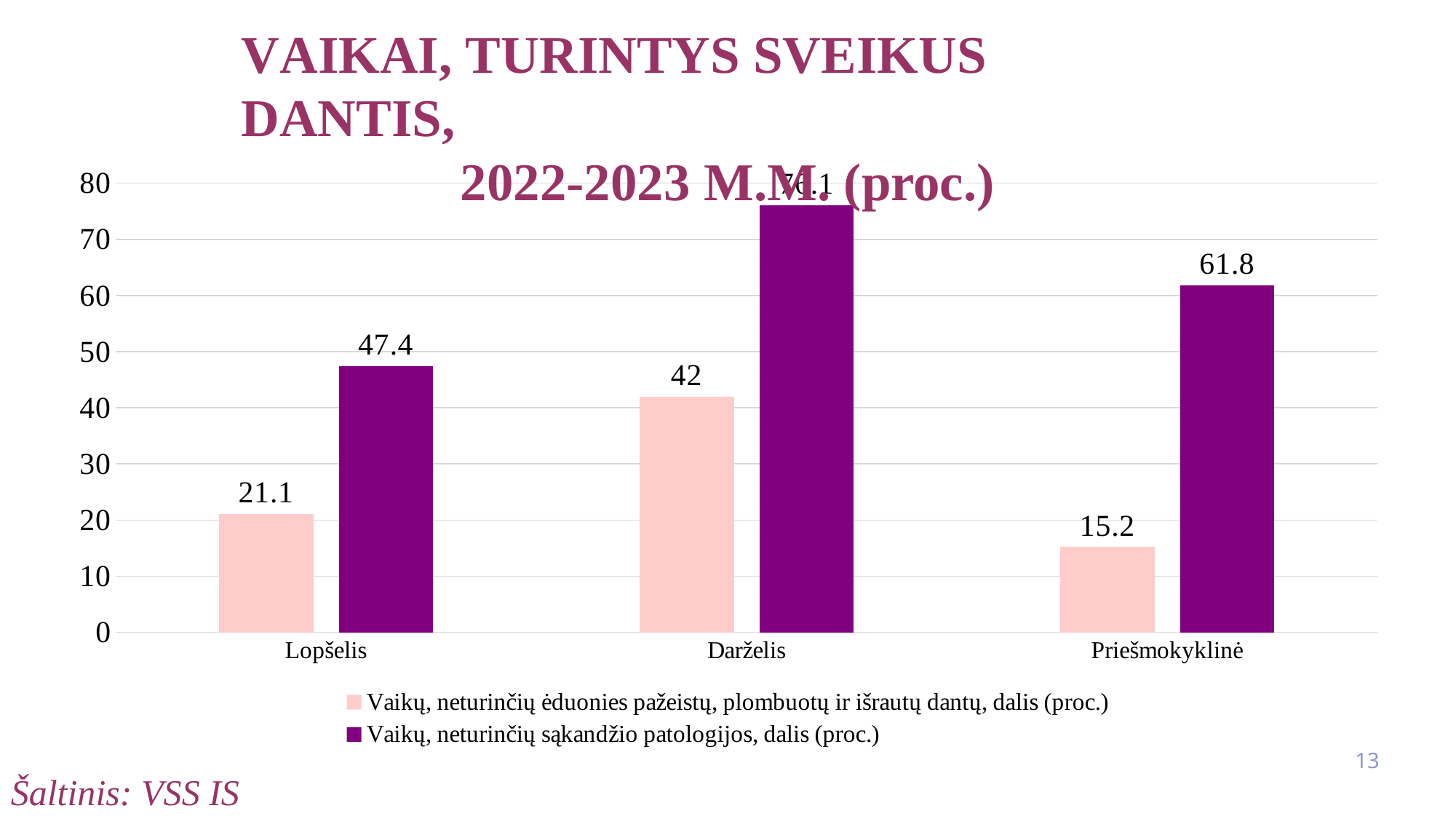
What kind of chart is shown on the slide? bar chart What is the value for Lopšelis in the series 'Vaikų, neturinčių sąkandžio patologijos, dalis (proc.)'? 47.4 Is the value for Darželis in the series 'Vaikų, neturinčių sąkandžio patologijos, dalis (proc.)' greater or less than 70? greater What is the value for Lopšelis in the series 'Vaikų, neturinčių ėduonies pažeistų, plombuotų ir išrautų dantų, dalis (proc.)'? 21.1 Which category has the highest value in the series 'Vaikų, neturinčių sąkandžio patologijos, dalis (proc.)'? Darželis Which is larger: the value for Lopšelis or for Darželis in the series 'Vaikų, neturinčių ėduonies pažeistų, plombuotų ir išrautų dantų, dalis (proc.)'? Darželis Which category has the lowest value in the series 'Vaikų, neturinčių ėduonies pažeistų, plombuotų ir išrautų dantų, dalis (proc.)'? Priešmokyklinė How many series does the legend list? 2 What is the value for Priešmokyklinė in the series 'Vaikų, neturinčių sąkandžio patologijos, dalis (proc.)'? 61.8 How many categories are shown on the x axis? 3 What is the value for Darželis in the series 'Vaikų, neturinčių ėduonies pažeistų, plombuotų ir išrautų dantų, dalis (proc.)'? 42 What is the difference between the two series' values for Priešmokyklinė? 46.6